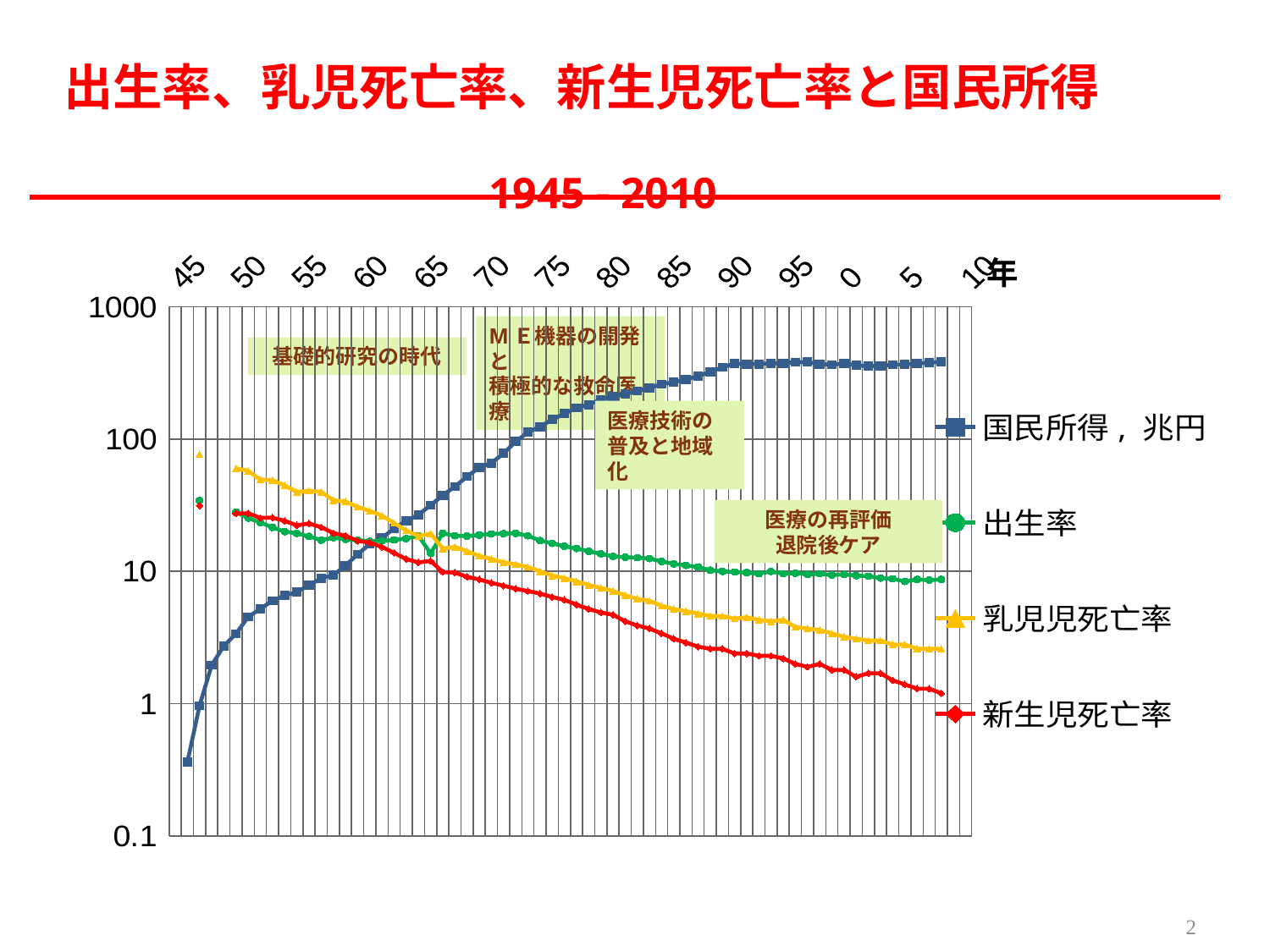
Does the 新生児死亡率 series rise or fall from 1950 to 2010? fall What is the title of the chart on the slide? 出生率、乳児死亡率、新生児死亡率と国民所得 1945－2010 Is the value of 国民所得，兆円 in 1945 greater or less than 1? less How many series does the legend list? 4 What kind of chart is shown on the slide? line chart Which series has the highest value in 2010? 国民所得，兆円 Does the 乳児児死亡率 series rise or fall from 1950 to 2010? fall In 2010, which is larger: 乳児児死亡率 or 新生児死亡率? 乳児児死亡率 Is the value of 国民所得，兆円 in 2010 greater or less than 100? greater Does the 国民所得，兆円 series rise or fall from 1945 to 2010? rise Which series is drawn with blue square markers? 国民所得，兆円 Is the value of 新生児死亡率 in 2010 greater or less than 10? less